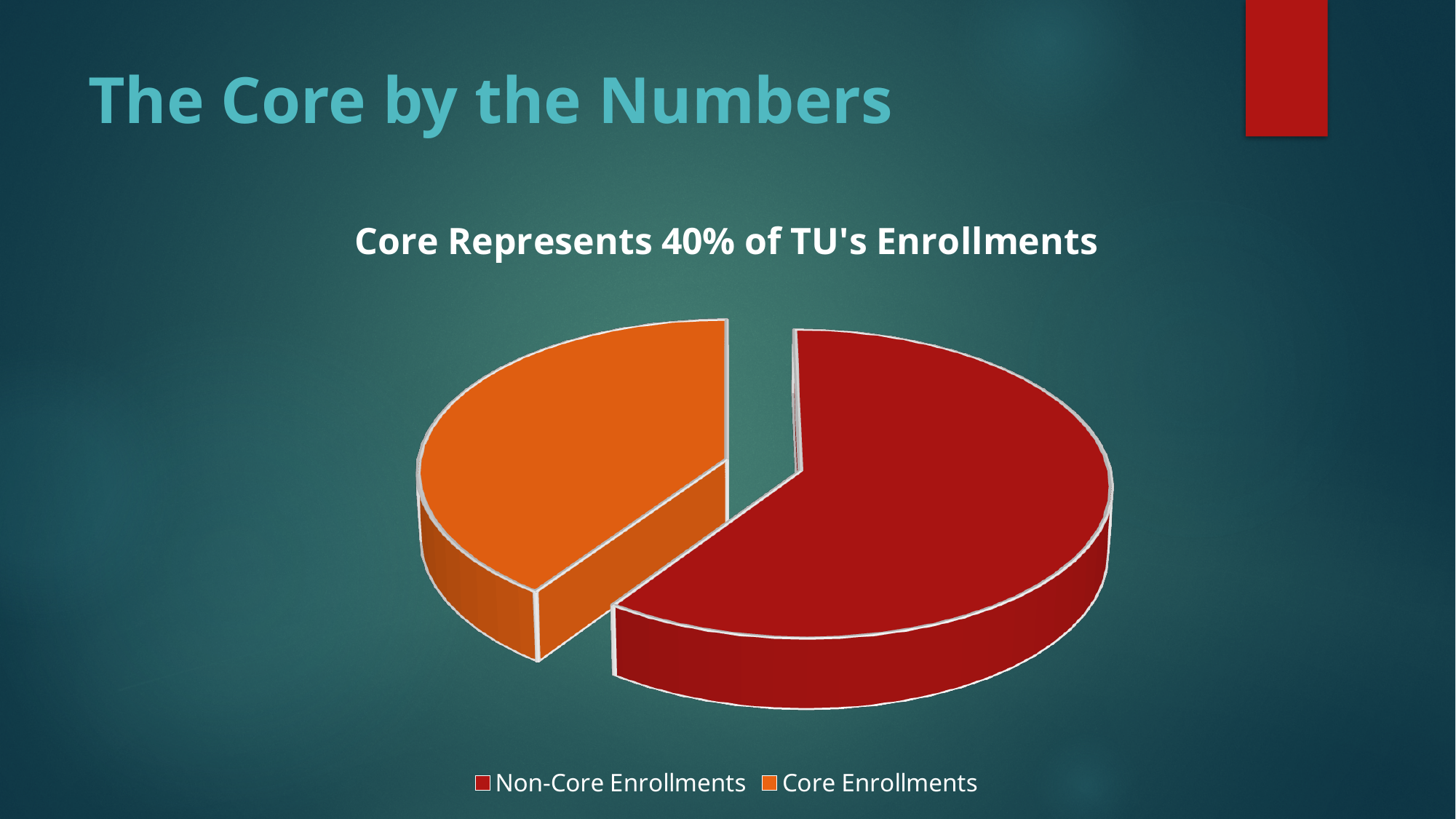
Which is larger, Non-Core Enrollments or Core Enrollments? Non-Core Enrollments What kind of chart is shown on the slide? Pie chart Which slice is the smallest in the pie chart? Core Enrollments How many entries does the legend list? 2 What is the title of the chart? Core Represents 40% of TU's Enrollments Is the Core Enrollments slice greater or less than half of the pie? less What colour is the Core Enrollments slice? Orange What share of TU's enrollments does the Core represent, according to the chart title? 40% How many slices does the pie chart have? 2 Which slice is the largest in the pie chart? Non-Core Enrollments